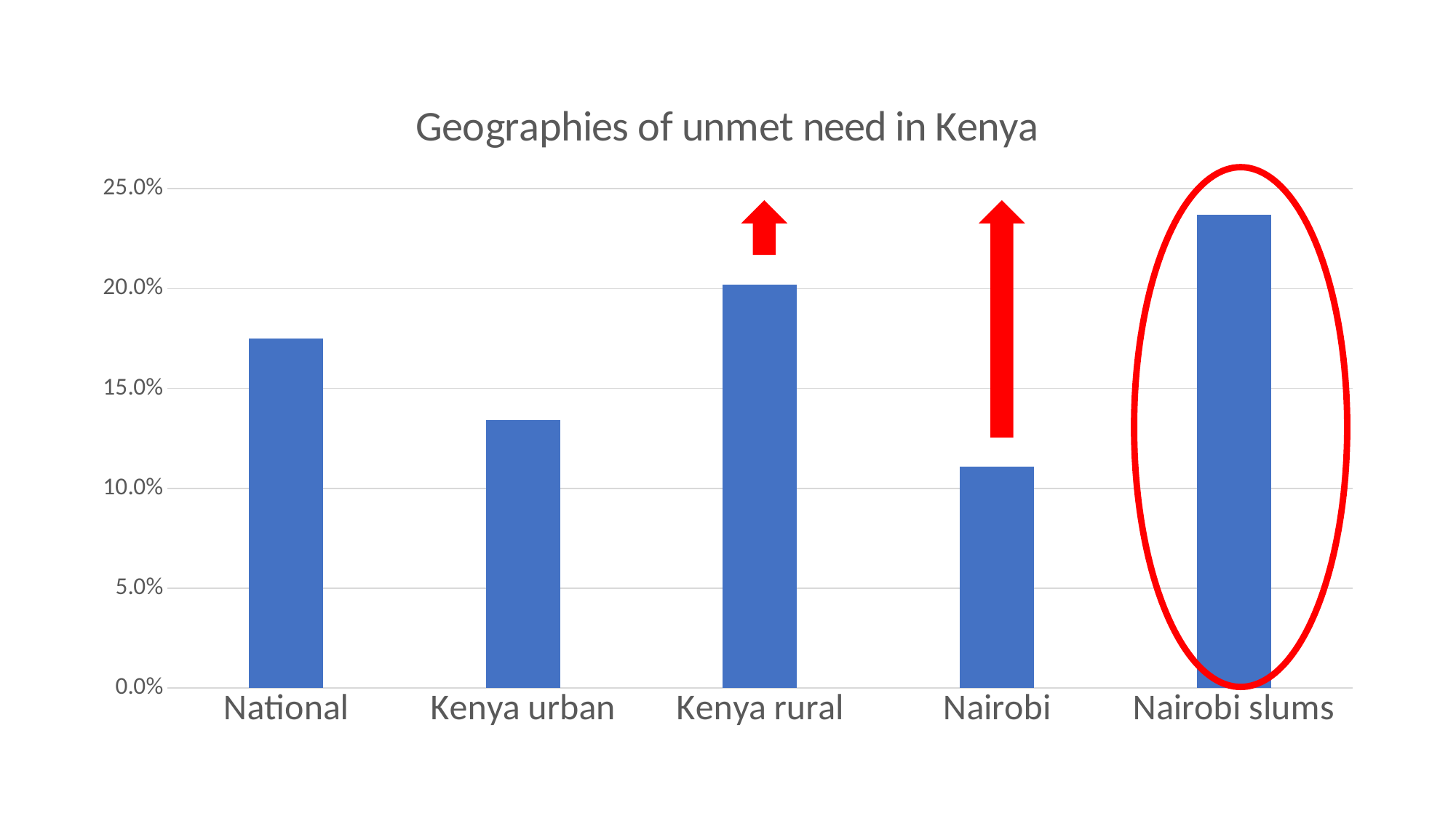
Is the value for Kenya rural greater or less than 15.0%? greater How many categories are shown on the x axis of the chart? 5 What kind of chart is shown on the slide? bar chart Which category has the highest value in the chart? Nairobi slums Is the value for National greater or less than 15.0%? greater Is the value for Nairobi greater or less than 15.0%? less Which is larger, the value for Kenya rural or the value for Kenya urban? Kenya rural What is the title of the chart? Geographies of unmet need in Kenya Which category on the chart is circled in red? Nairobi slums Which category has the lowest value in the chart? Nairobi